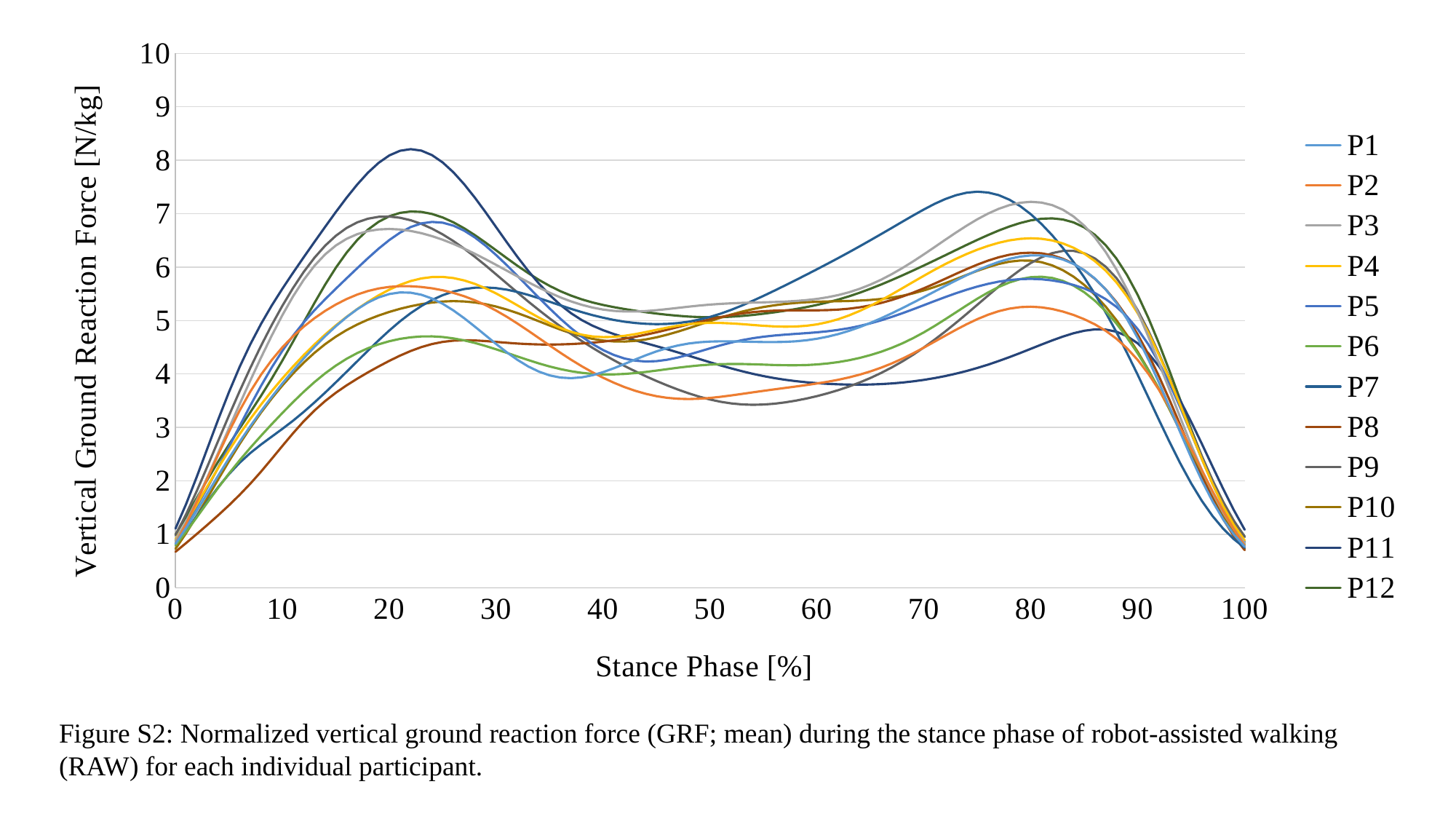
Which series reaches the highest value anywhere on the chart? P11 How many series does the legend list? 12 Do the values rise or fall along the x axis between 90% and 100% stance phase? fall What is the label of the x axis? Stance Phase [%] What kind of chart is shown on the slide? line chart What is the highest value shown on the y axis? 10 Is the value for P7 at 75% stance phase greater or less than 7? greater What is the label of the y axis? Vertical Ground Reaction Force [N/kg] Is the value for P9 at 55% stance phase greater or less than 4? less Is the value for P8 at 10% stance phase greater or less than 3? less Do the values rise or fall along the x axis between 0% and 20% stance phase? rise